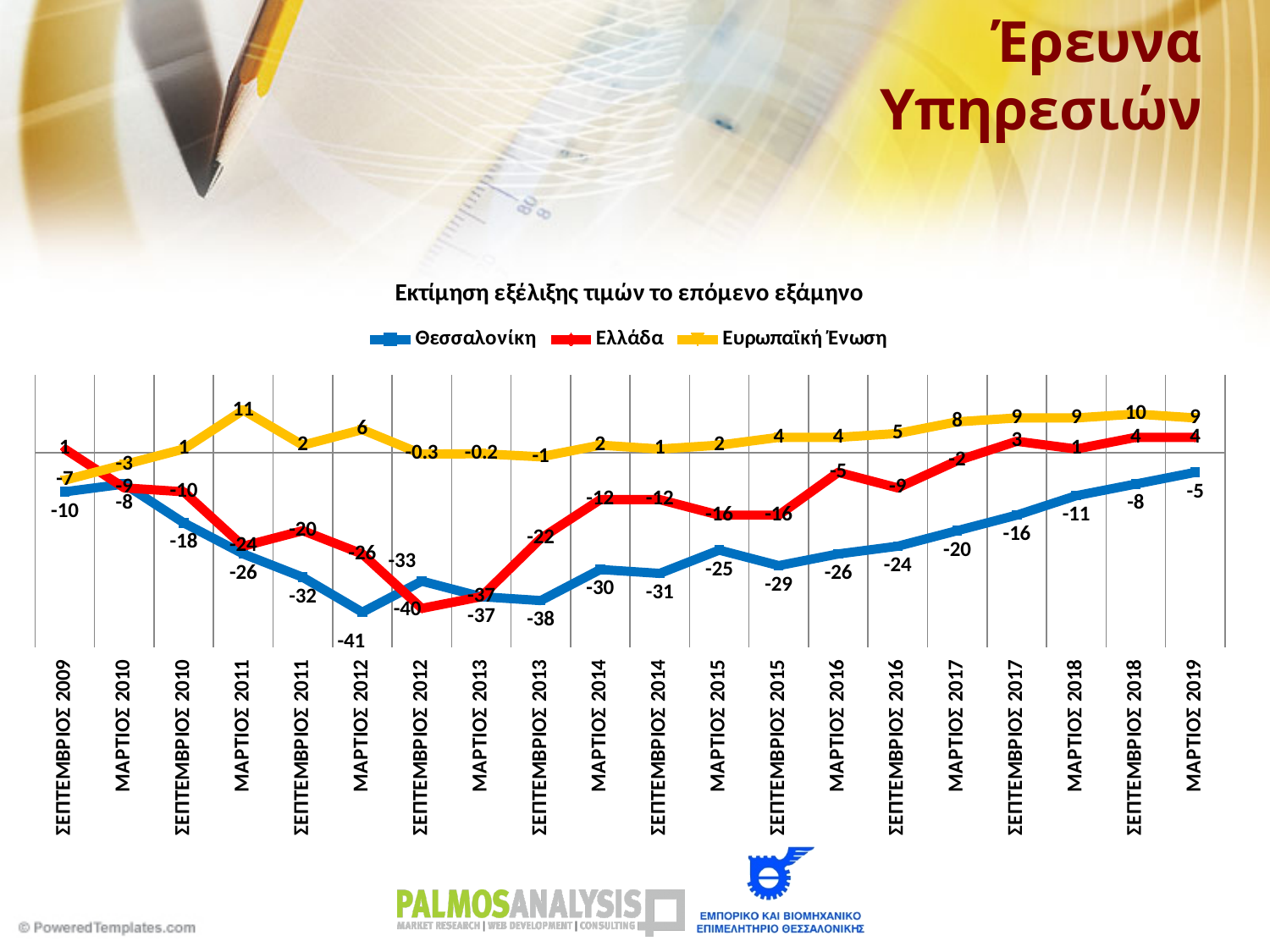
What is the value for Θεσσαλονίκη in ΜΑΡΤΙΟΣ 2012? -41 What is the value for Ελλάδα in ΣΕΠΤΕΜΒΡΙΟΣ 2012? -40 Does the Θεσσαλονίκη series generally rise or fall from ΣΕΠΤΕΜΒΡΙΟΣ 2013 to ΜΑΡΤΙΟΣ 2019? rise How many series does the legend list? 3 What kind of chart is shown on the slide? line chart What is the value for Ευρωπαϊκή Ένωση in ΣΕΠΤΕΜΒΡΙΟΣ 2018? 10 In which period does the Θεσσαλονίκη series reach its lowest value? ΜΑΡΤΙΟΣ 2012 In which period does the Ευρωπαϊκή Ένωση series reach its highest value? ΜΑΡΤΙΟΣ 2011 What is the difference between the Ελλάδα and Θεσσαλονίκη values in ΜΑΡΤΙΟΣ 2019? 9 What is the title of the chart? Εκτίμηση εξέλιξης τιμών το επόμενο εξάμηνο In ΜΑΡΤΙΟΣ 2016, which is larger: the value for Ελλάδα or the value for Θεσσαλονίκη? Ελλάδα How many time points are plotted along the x axis? 20